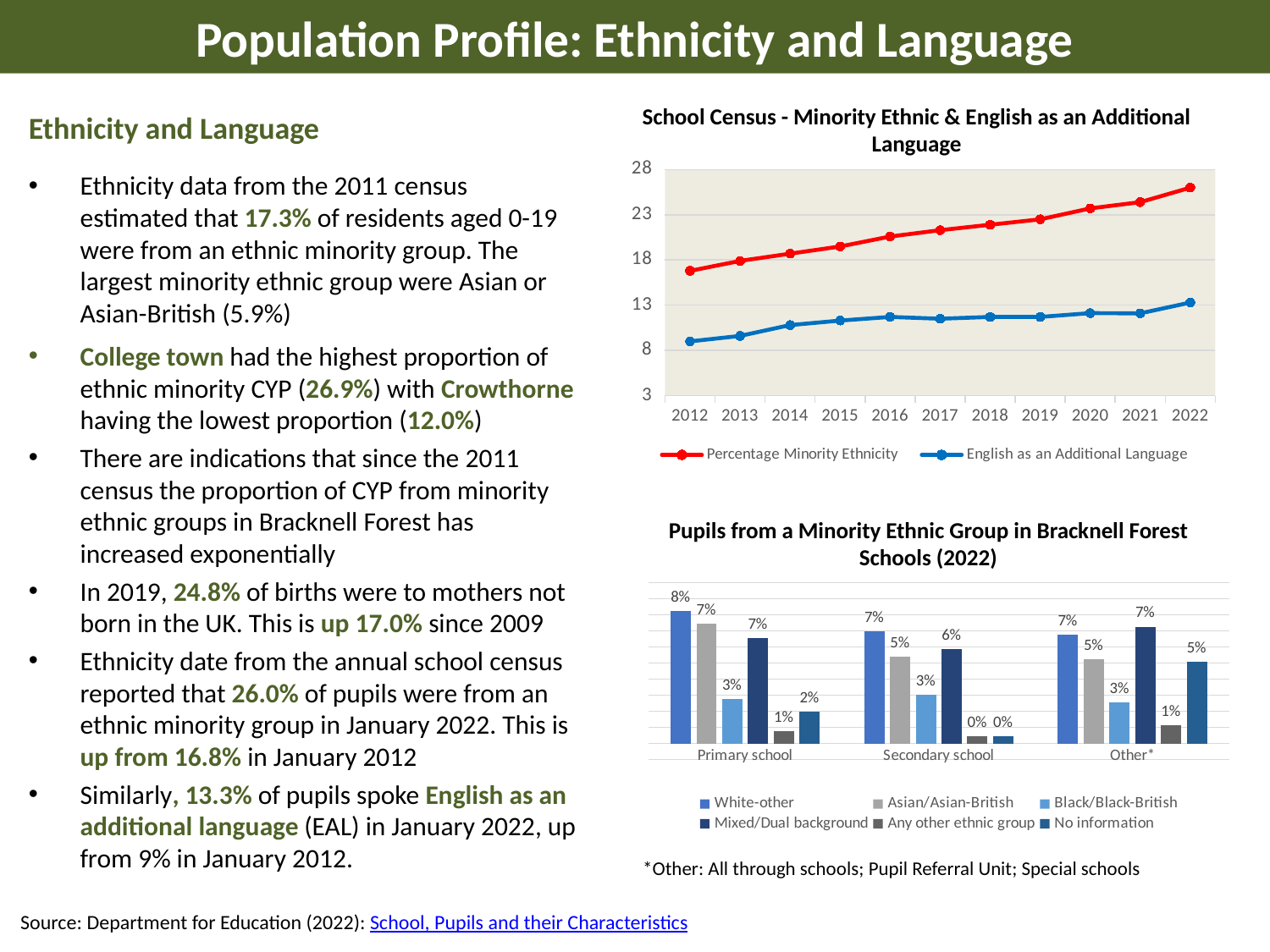
How many series does the legend of the 'School Census - Minority Ethnic & English as an Additional Language' chart list? 2 How many series does the legend of the 'Pupils from a Minority Ethnic Group in Bracknell Forest Schools (2022)' chart list? 6 In the 'Pupils from a Minority Ethnic Group in Bracknell Forest Schools (2022)' chart, what is the White-other value for Primary school? 8% What kind of chart is the 'School Census - Minority Ethnic & English as an Additional Language' chart? line chart In the 'School Census - Minority Ethnic & English as an Additional Language' chart, does the Percentage Minority Ethnicity line rise or fall from 2012 to 2022? rise In the 'School Census - Minority Ethnic & English as an Additional Language' chart, is the Percentage Minority Ethnicity value for 2022 greater or less than 23? greater What kind of chart is the 'Pupils from a Minority Ethnic Group in Bracknell Forest Schools (2022)' chart? bar chart In the 'Pupils from a Minority Ethnic Group in Bracknell Forest Schools (2022)' chart, what is the No information value for Other*? 5% How many years are plotted on the x axis of the 'School Census - Minority Ethnic & English as an Additional Language' chart? 11 In the 'School Census - Minority Ethnic & English as an Additional Language' chart, is the English as an Additional Language value for 2012 greater or less than 13? less In the 'Pupils from a Minority Ethnic Group in Bracknell Forest Schools (2022)' chart, which ethnic group has the highest value for Secondary school? White-other In the 'Pupils from a Minority Ethnic Group in Bracknell Forest Schools (2022)' chart, is the Asian/Asian-British value larger for Primary school or Secondary school? Primary school